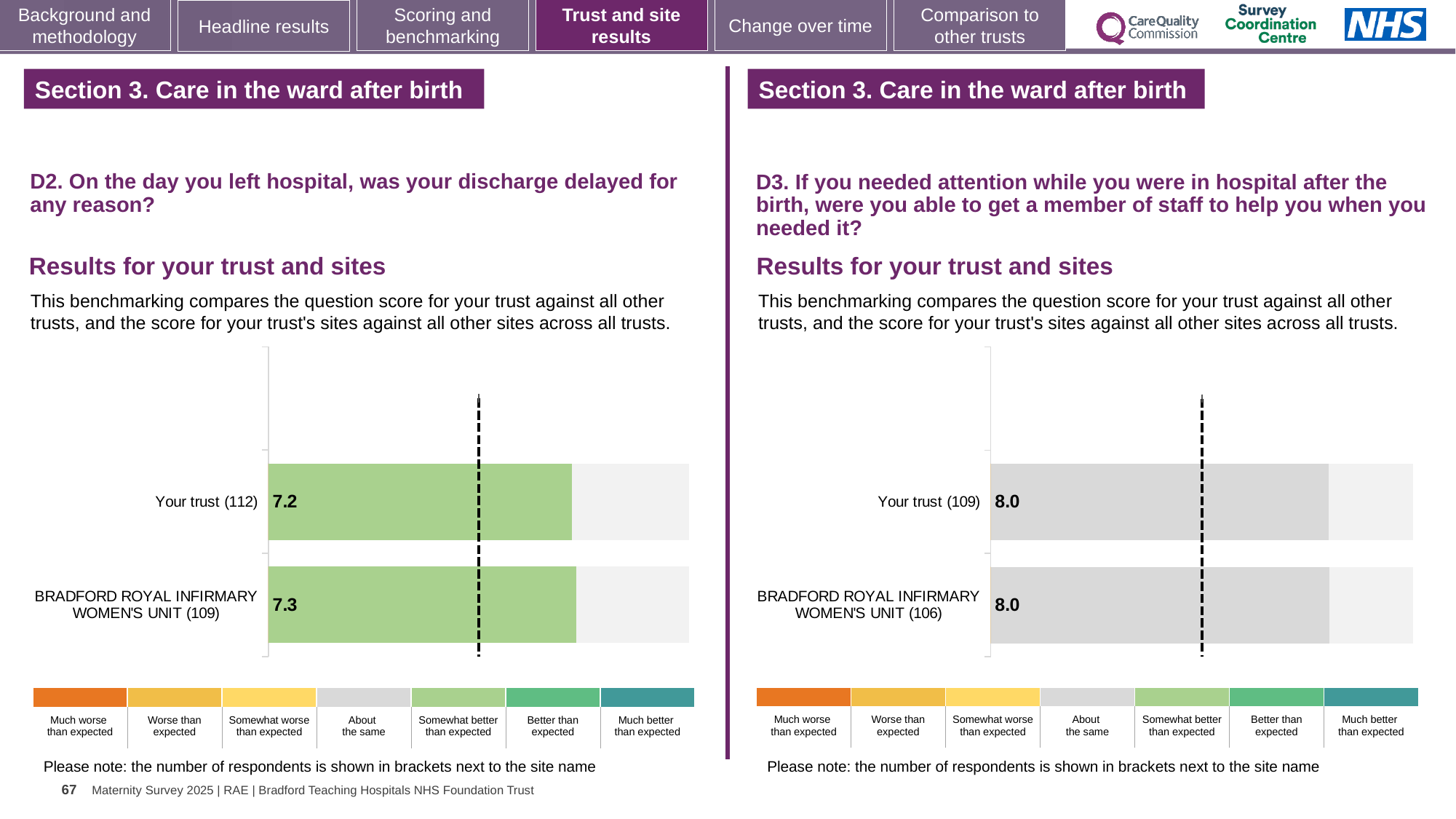
In the D2 chart on the left, how many respondents are shown in brackets for Your trust? 112 In the D2 chart on the left, which has the higher score, Your trust or Bradford Royal Infirmary Women's Unit? Bradford Royal Infirmary Women's Unit In the D3 chart on the right, what is the score for Bradford Royal Infirmary Women's Unit? 8.0 In the D3 chart on the right, how many respondents are shown in brackets for Bradford Royal Infirmary Women's Unit? 106 In the D2 chart on the left, what is the score for Your trust? 7.2 What type of chart is used for the D2 results on the left? Bar chart In the D2 chart on the left, what is the score for Bradford Royal Infirmary Women's Unit? 7.3 In the D3 chart on the right, what is the score for Your trust? 8.0 According to the colour key, which benchmark category do the green bars in the D2 chart on the left represent? Somewhat better than expected In the D2 chart on the left, what is the difference between the Bradford Royal Infirmary Women's Unit score and the Your trust score? 0.1 According to the colour key, which benchmark category do the grey bars in the D3 chart on the right represent? About the same How many bars are plotted in the D3 chart on the right? 2